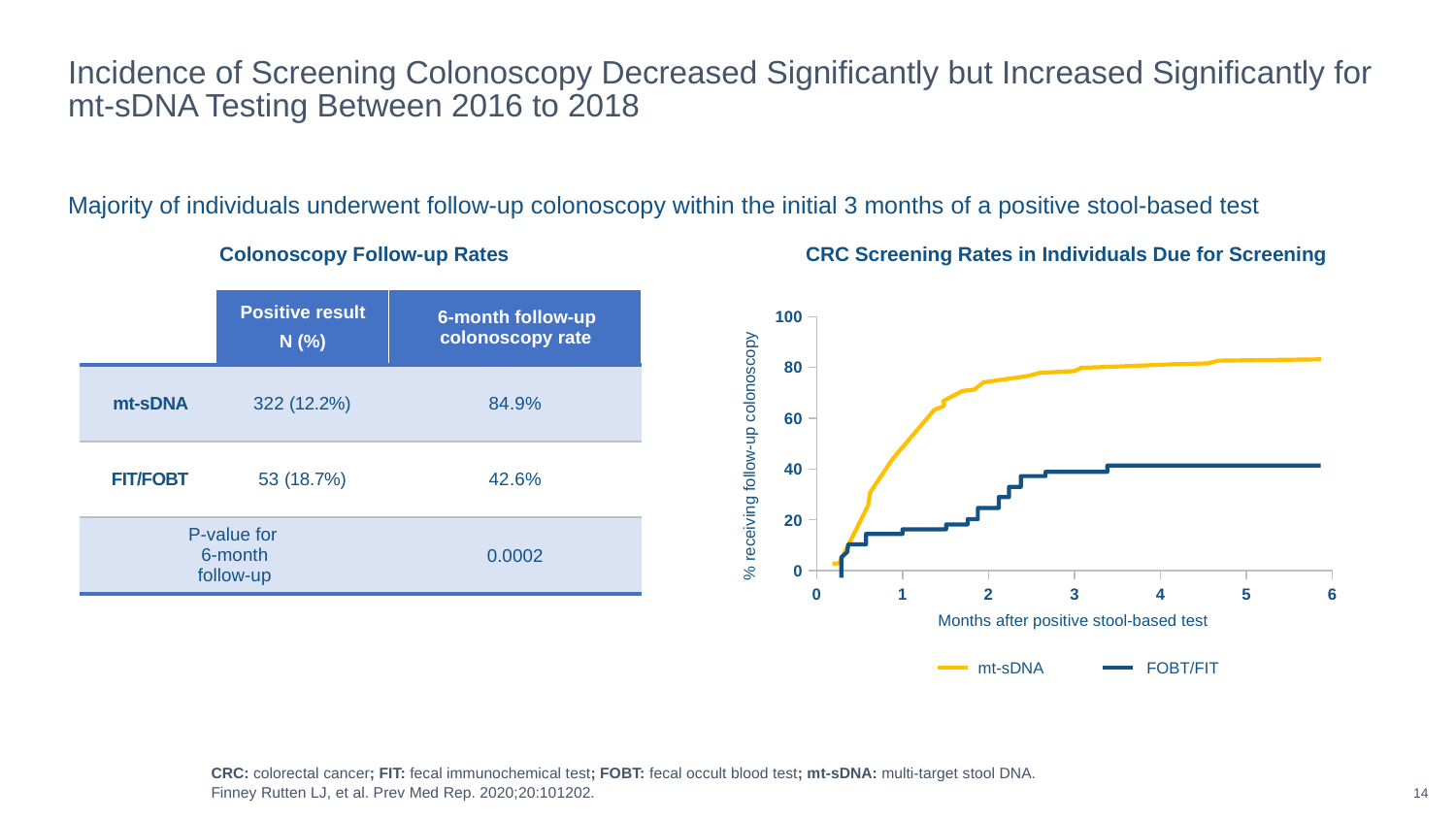
In the "CRC Screening Rates in Individuals Due for Screening" chart, is the mt-sDNA value at 2 months greater or less than 60? greater In the "CRC Screening Rates in Individuals Due for Screening" chart, is the FOBT/FIT value at 3 months greater or less than 20? greater In the "CRC Screening Rates in Individuals Due for Screening" chart, which series reaches the higher value at 6 months, mt-sDNA or FOBT/FIT? mt-sDNA In the "CRC Screening Rates in Individuals Due for Screening" chart, is the FOBT/FIT value at 1 month greater or less than 20? less What is the label of the x axis in the "CRC Screening Rates in Individuals Due for Screening" chart? Months after positive stool-based test In the "CRC Screening Rates in Individuals Due for Screening" chart, do the mt-sDNA values rise or fall as months after the positive test increase? rise In the "CRC Screening Rates in Individuals Due for Screening" chart, which colour is used for the mt-sDNA line? yellow In the "CRC Screening Rates in Individuals Due for Screening" chart, which series has the lower value at 4 months? FOBT/FIT How many series does the legend of the "CRC Screening Rates in Individuals Due for Screening" chart list? 2 What kind of chart is "CRC Screening Rates in Individuals Due for Screening"? line chart